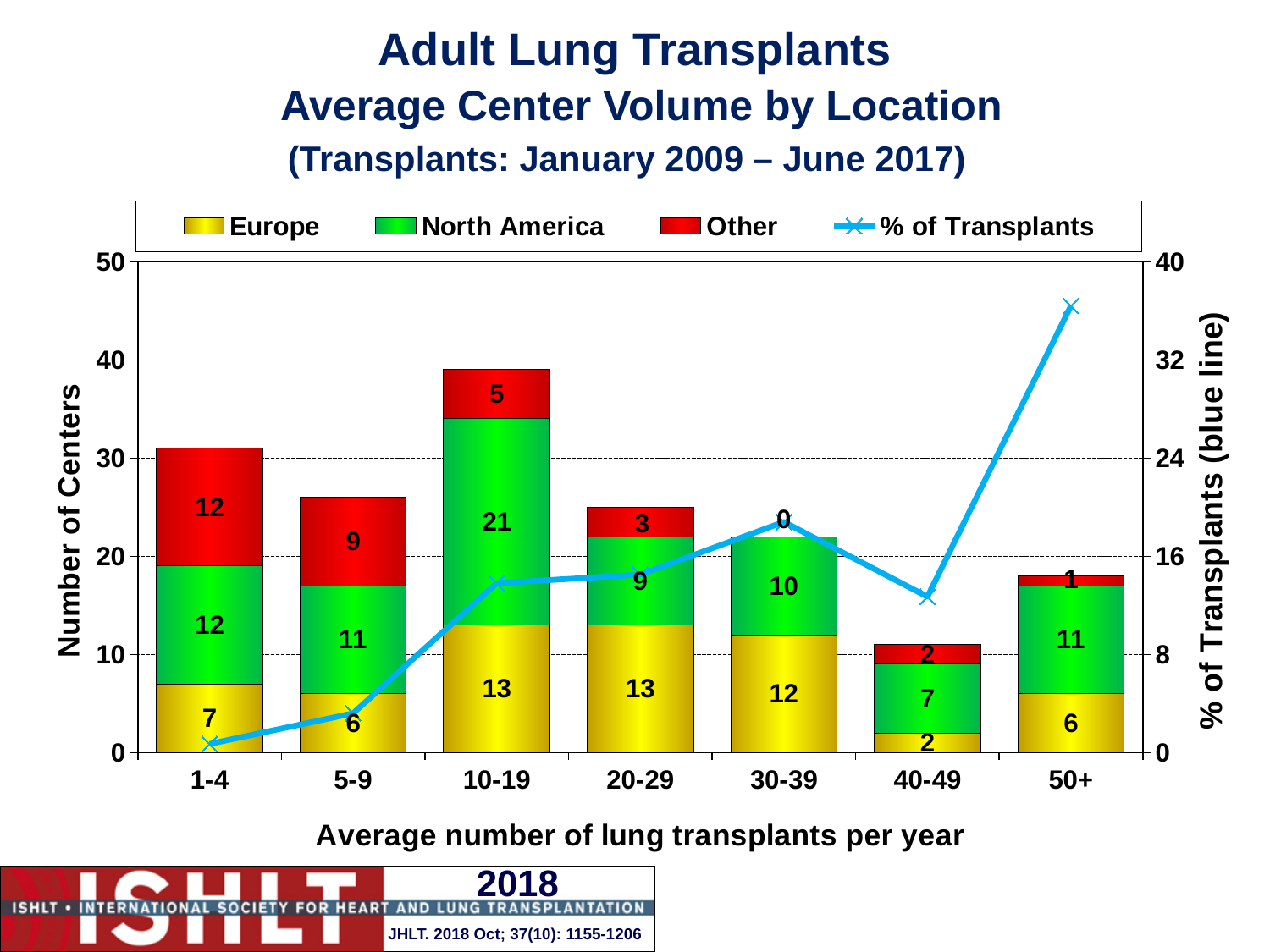
What is the difference between the North America values for 10-19 and 5-9? 10 Is the % of Transplants value for the 50+ category greater or less than 32? greater What is the total number of centers in the 10-19 stacked bar? 39 How many series does the legend list? 4 Does the % of Transplants line rise or fall from the 1-4 category to the 10-19 category? rise How many categories are shown on the x axis? 7 Which category has the highest North America value? 10-19 Which is larger, the Europe value for 20-29 or the Europe value for 50+? 20-29 What is the Other value for the 1-4 category? 12 Which category has the lowest Other value? 30-39 What is the North America value for the 10-19 category? 21 How many centers in Europe have an average of 10-19 lung transplants per year? 13